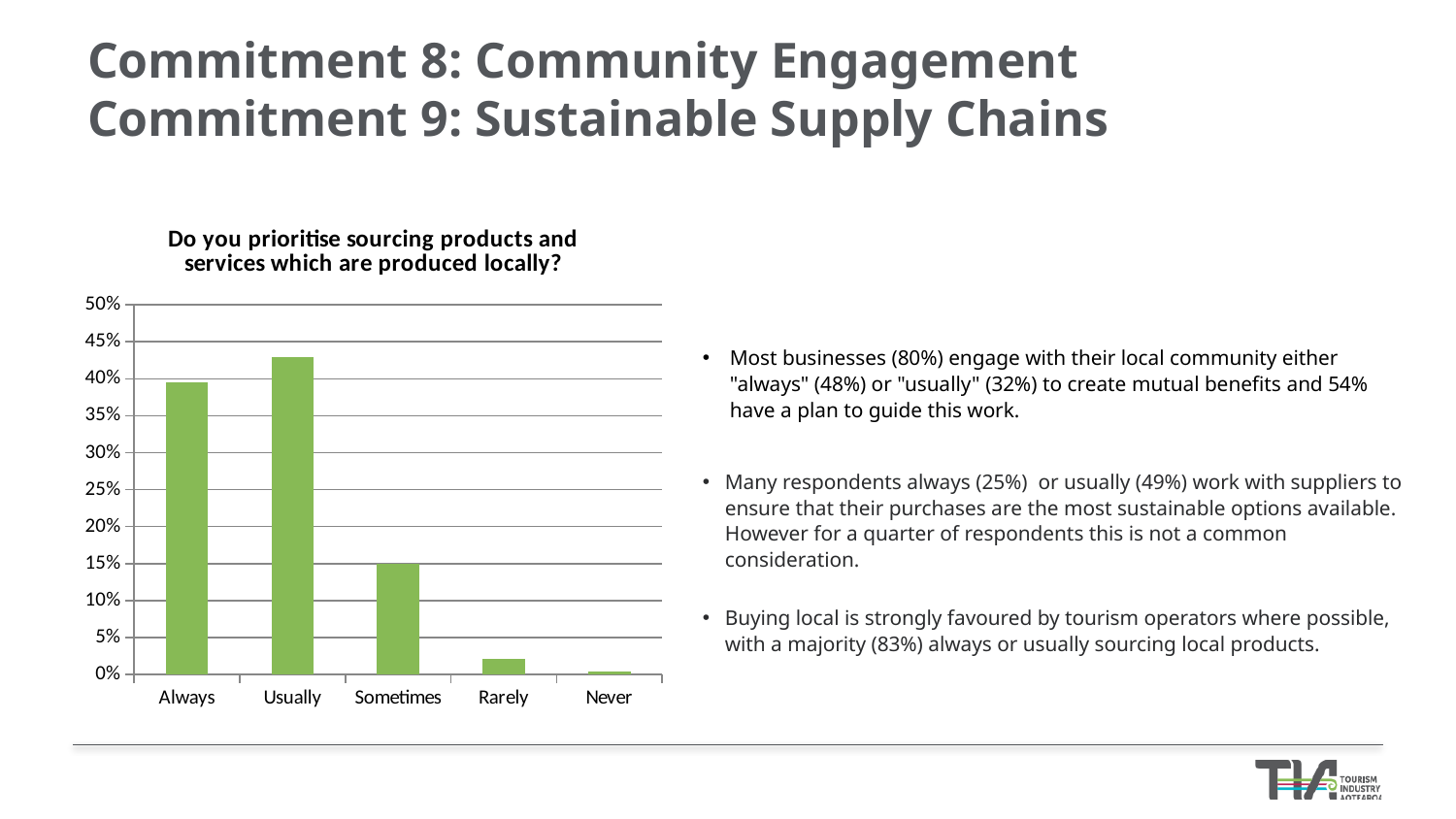
What is the title of the chart? Do you prioritise sourcing products and services which are produced locally? Is the value for Sometimes greater or less than 20%? less Is the value for Rarely greater or less than 5%? less Is the value for Always greater or less than 35%? greater Which is larger, the value for Sometimes or the value for Rarely? Sometimes Which is larger, the value for Always or the value for Sometimes? Always What kind of chart is shown on the slide? bar chart Which response category has the highest value in the chart? Usually Moving from Usually to Never along the x axis, do the values rise or fall? fall How many response categories are shown on the x axis of the chart? 5 Which response category has the lowest value in the chart? Never